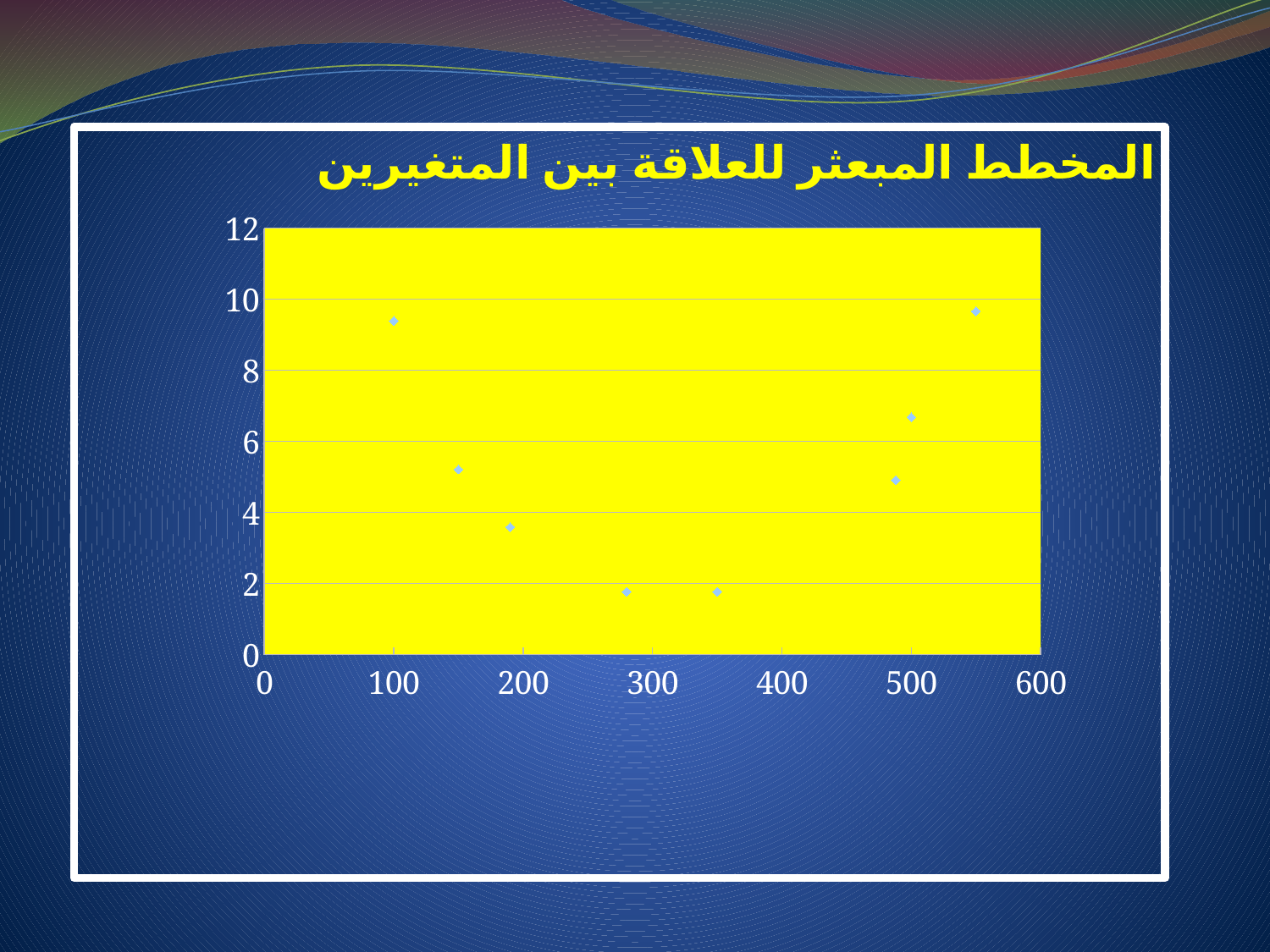
What kind of chart is shown on the slide? scatter chart Is the value of the point plotted near x = 550 greater or less than 8? greater Is the value of the point plotted near x = 150 greater or less than 8? less Is the value of the point plotted near x = 100 greater or less than 8? greater Which of the two points, the one near x = 100 or the one near x = 150, has the larger value? the one near x = 100 How many data points are plotted on the chart? 8 What is the highest value shown on the vertical axis? 12 What is the highest value shown on the horizontal axis? 600